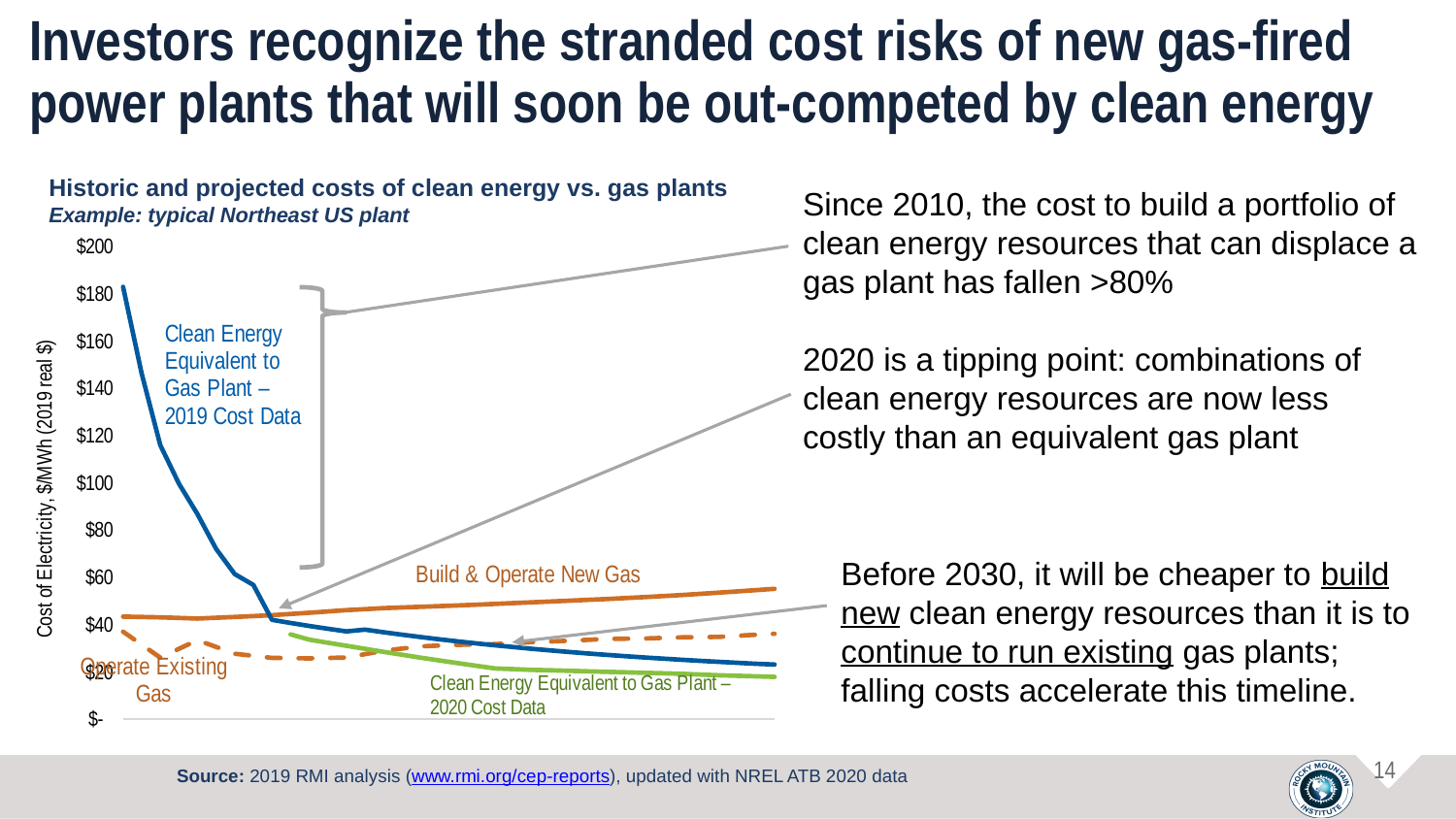
What is the title of the chart? Historic and projected costs of clean energy vs. gas plants Does the 'Clean Energy Equivalent to Gas Plant – 2020 Cost Data' line rise or fall from left to right? Fall What kind of chart is shown on the slide? Line chart Does the 'Build & Operate New Gas' line rise or fall from left to right? Rise Which line reaches the highest value on the chart? Clean Energy Equivalent to Gas Plant – 2019 Cost Data At the right end of the chart, which is higher: 'Build & Operate New Gas' or 'Clean Energy Equivalent to Gas Plant – 2020 Cost Data'? Build & Operate New Gas Is the starting value of the 'Clean Energy Equivalent to Gas Plant – 2019 Cost Data' line greater or less than $160? greater Is the value at the right end of the 'Clean Energy Equivalent to Gas Plant – 2020 Cost Data' line greater or less than $40? less What is the label on the chart's vertical axis? Cost of Electricity, $/MWh (2019 real $) Is the value at the right end of the 'Build & Operate New Gas' line greater or less than $40? greater How many labeled lines are plotted on the chart? 4 Does the 'Clean Energy Equivalent to Gas Plant – 2019 Cost Data' line rise or fall from left to right? Fall